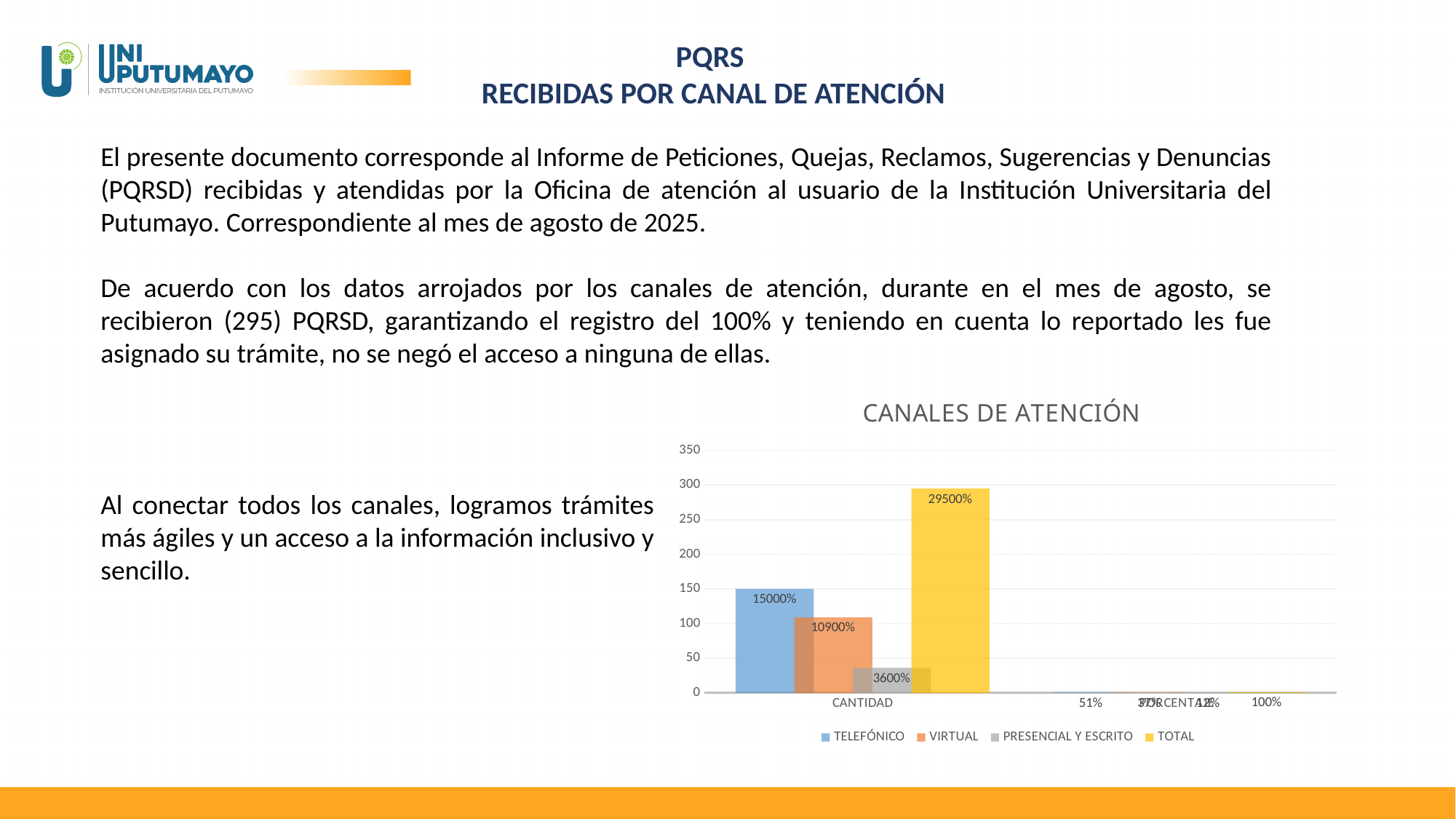
What colour is the TOTAL series in the chart? yellow What is the data label on the TOTAL bar in the CANTIDAD group? 29500% Which series has the shortest bar in the CANTIDAD group? PRESENCIAL Y ESCRITO What is the data label on the VIRTUAL bar in the CANTIDAD group? 10900% Is the TOTAL bar in the CANTIDAD group greater or less than 250 on the vertical axis? greater What kind of chart is shown under the title CANALES DE ATENCIÓN? bar chart What is the title of the chart on the slide? CANALES DE ATENCIÓN Which series has the tallest bar in the CANTIDAD group? TOTAL What is the data label on the PRESENCIAL Y ESCRITO bar in the CANTIDAD group? 3600% What is the data label on the TELEFÓNICO bar in the CANTIDAD group? 15000% In the CANTIDAD group, which bar is taller: TELEFÓNICO or VIRTUAL? TELEFÓNICO How many series does the legend of the CANALES DE ATENCIÓN chart list? 4